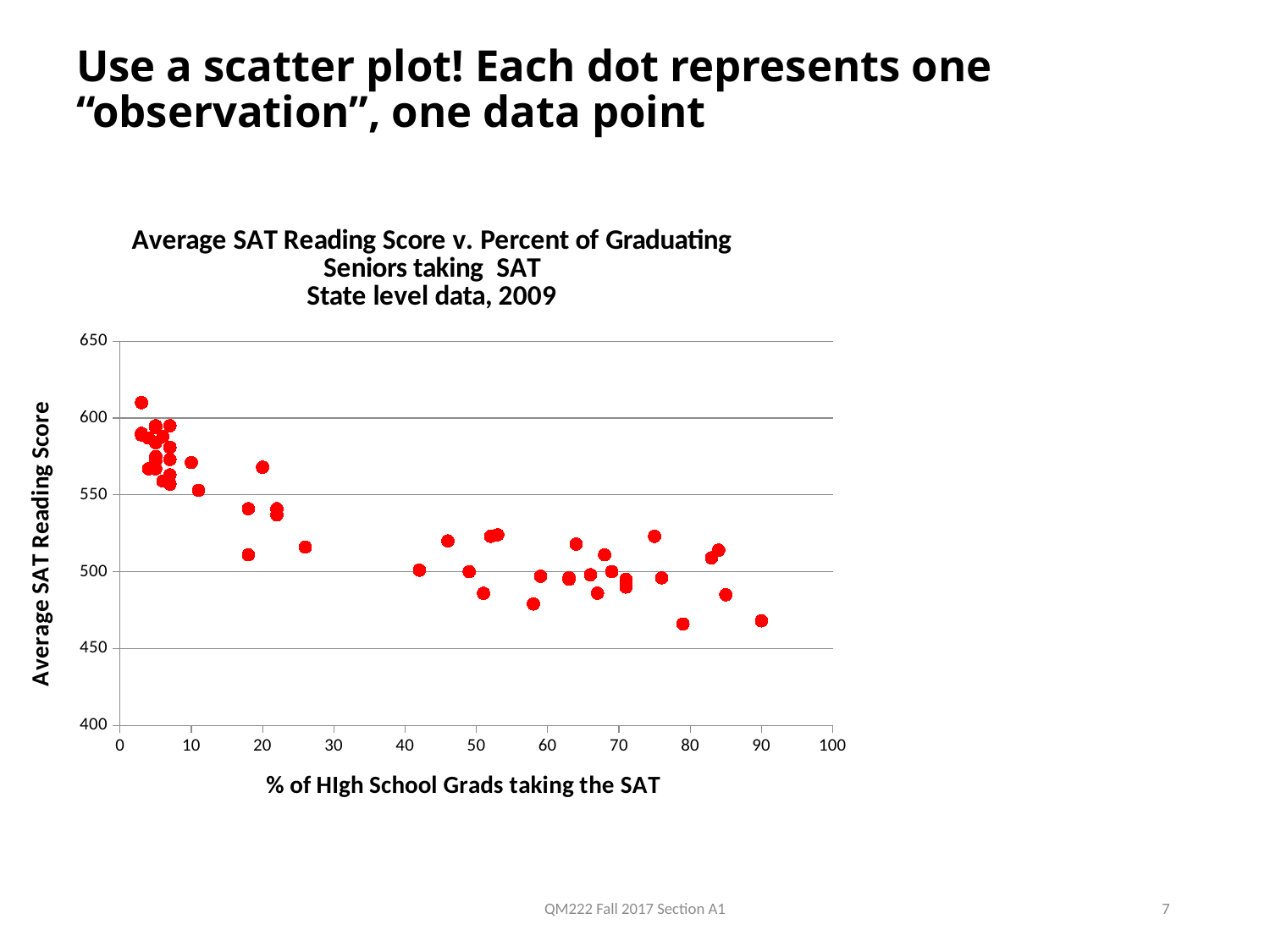
What is the label on the x axis of the chart? % of HIgh School Grads taking the SAT Is the average SAT reading score of the rightmost point (near 90% on the x axis) greater or less than 500? less What is the title of the chart? Average SAT Reading Score v. Percent of Graduating Seniors taking SAT State level data, 2009 What kind of chart is shown on the slide? scatter plot Is the average SAT reading score of the highest point on the chart greater or less than 600? greater Are all points with more than 40% of grads taking the SAT below an average reading score of 550? yes As the percent of high school grads taking the SAT increases along the x axis, does the average SAT reading score generally rise or fall? fall